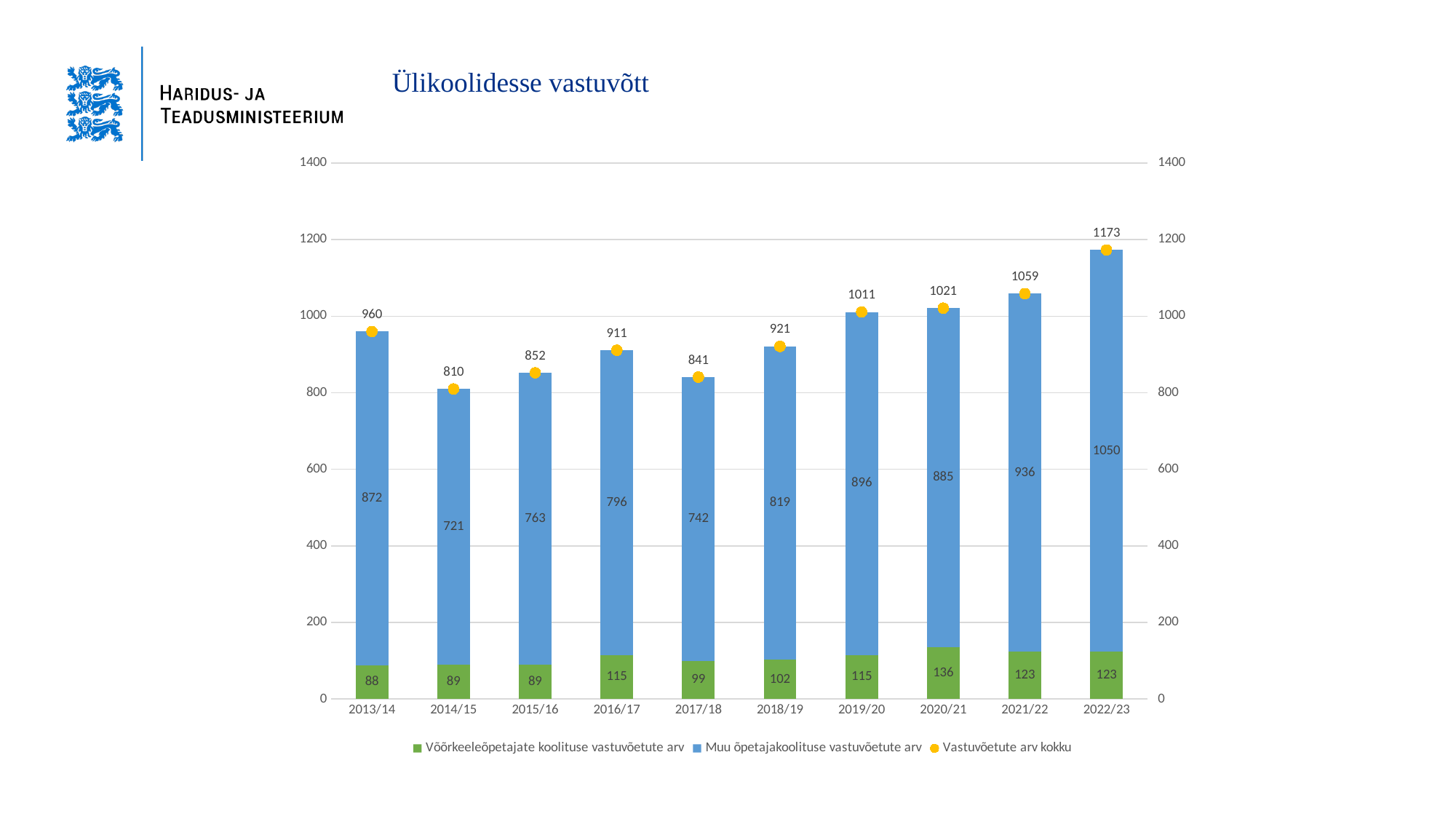
What is the difference between the 'Vastuvõetute arv kokku' values for 2022/23 and 2021/22? 114 What is the value of 'Muu õpetajakoolituse vastuvõetute arv' for 2013/14? 872 What is the title of the chart? Ülikoolidesse vastuvõtt Which year has the lowest 'Vastuvõetute arv kokku'? 2014/15 Is the 'Vastuvõetute arv kokku' value for 2019/20 greater or less than 1000? greater What kind of chart is shown on the slide? Stacked bar chart with markers Which is larger: 'Muu õpetajakoolituse vastuvõetute arv' in 2016/17 or in 2018/19? 2018/19 What is the 'Vastuvõetute arv kokku' value for 2017/18? 841 How many academic years are shown on the x axis? 10 Which year has the highest 'Vastuvõetute arv kokku'? 2022/23 What is the value of 'Võõrkeeleõpetajate koolituse vastuvõetute arv' for 2020/21? 136 How many series does the legend list? 3